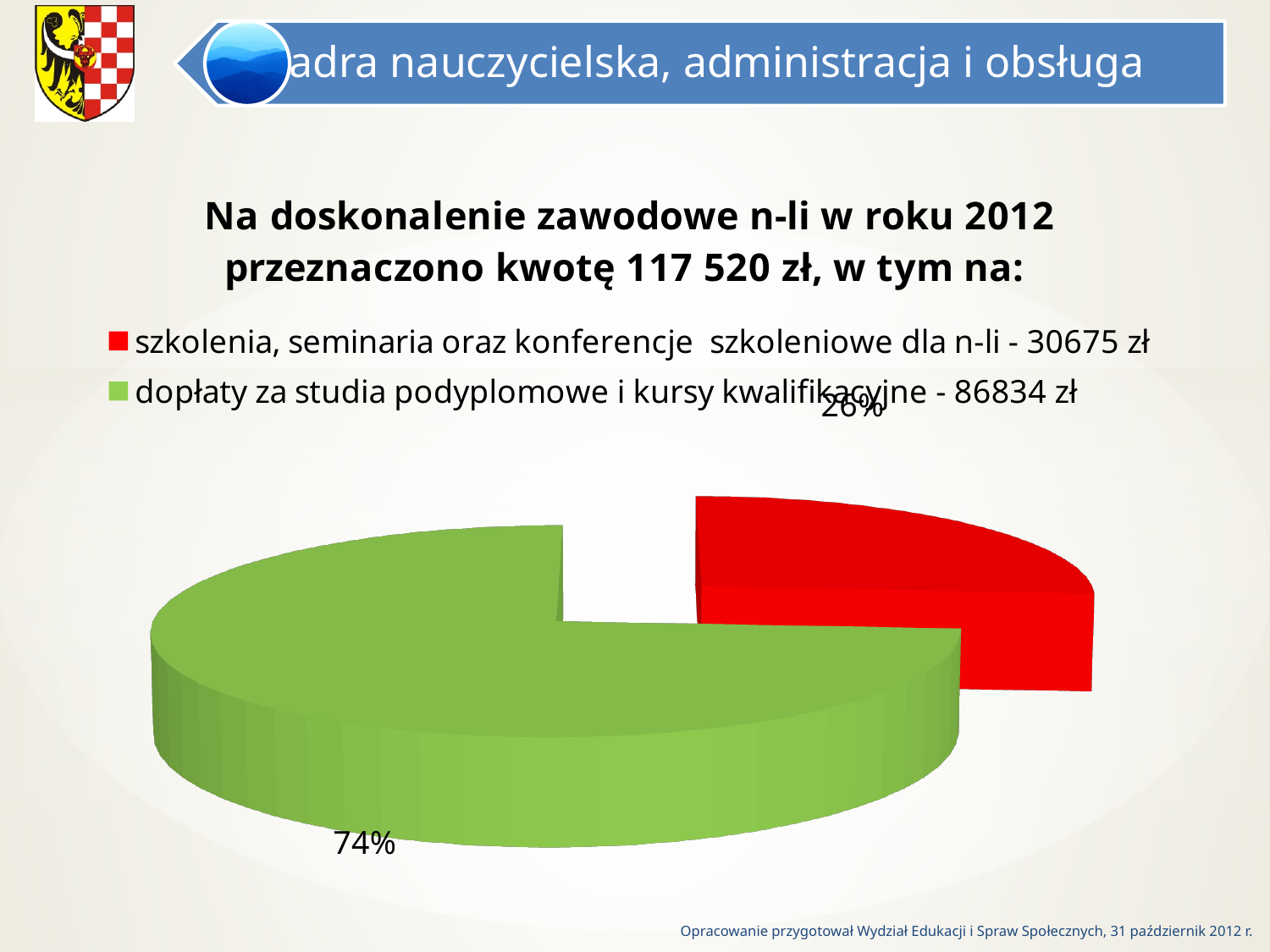
Which category has the smallest slice of the pie? szkolenia, seminaria oraz konferencje szkoleniowe dla n-li How many entries does the legend list? 2 What share of the pie is labelled for 'szkolenia, seminaria oraz konferencje szkoleniowe dla n-li'? 26% What colour is the slice representing 'szkolenia, seminaria oraz konferencje szkoleniowe dla n-li'? red Which is larger: the slice for 'szkolenia, seminaria oraz konferencje szkoleniowe dla n-li' or the slice for 'dopłaty za studia podyplomowe i kursy kwalifikacyjne'? dopłaty za studia podyplomowe i kursy kwalifikacyjne Which category has the largest slice of the pie? dopłaty za studia podyplomowe i kursy kwalifikacyjne According to the legend, what amount in zł is given for 'szkolenia, seminaria oraz konferencje szkoleniowe dla n-li'? 30675 zł By how many percentage points does the 74% slice exceed the 26% slice? 48 According to the legend, what amount in zł is given for 'dopłaty za studia podyplomowe i kursy kwalifikacyjne'? 86834 zł What kind of chart is shown on the slide? pie chart How many slices does the pie chart have? 2 What share of the pie is labelled for 'dopłaty za studia podyplomowe i kursy kwalifikacyjne'? 74%